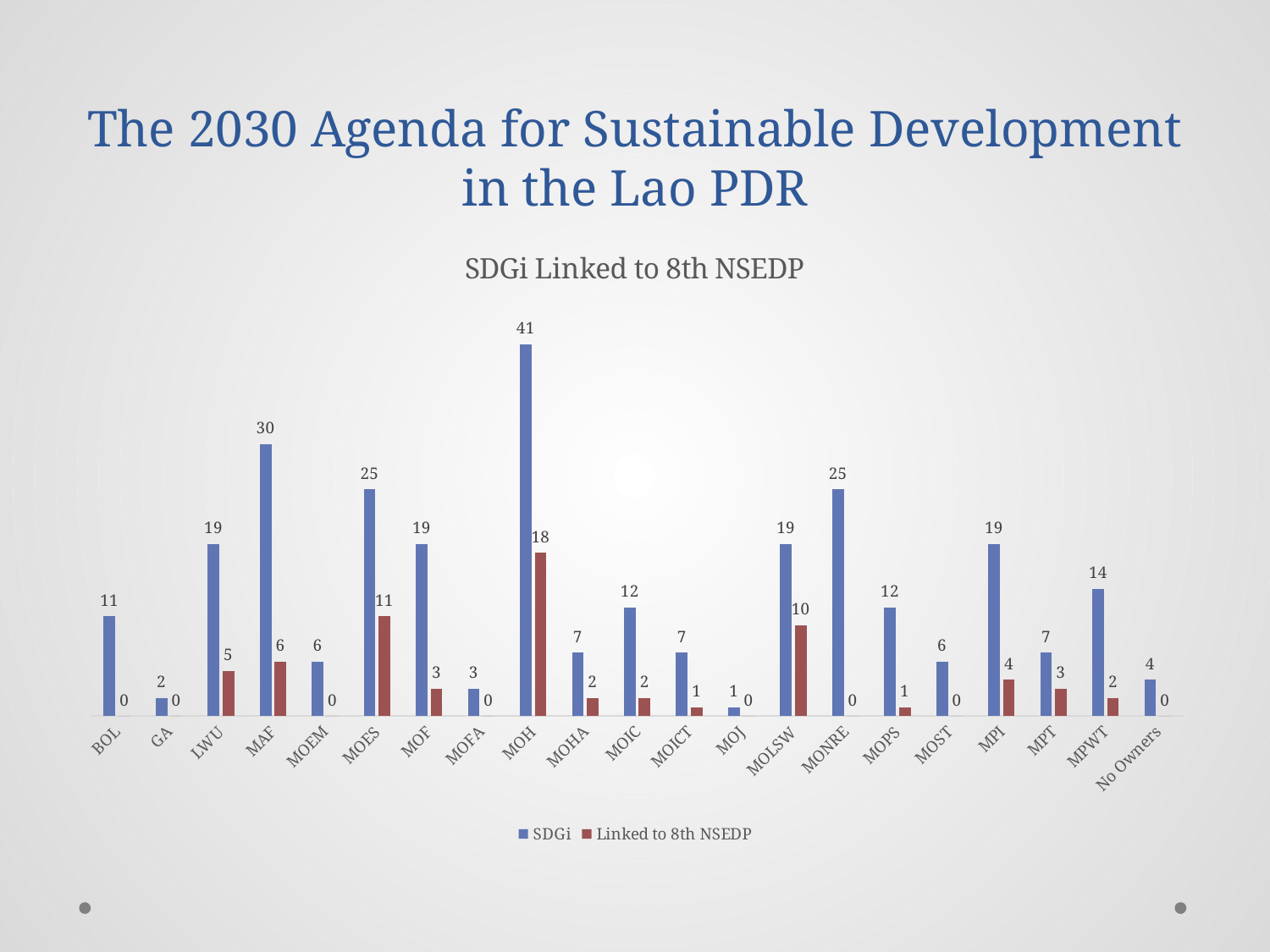
What is the difference between the SDGi value and the Linked to 8th NSEDP value for MOH? 23 Which category has the lowest SDGi value? MOJ What is the SDGi value for MPWT? 14 What kind of chart is shown on the slide? Bar chart Which is larger, the SDGi value for MAF or the SDGi value for MONRE? MAF What is the Linked to 8th NSEDP value for MOES? 11 Which category has the highest SDGi value? MOH How many categories are shown on the x axis? 21 How many series does the legend list? 2 What is the title of the chart? SDGi Linked to 8th NSEDP What is the SDGi value for MOH? 41 Which series is shown in red? Linked to 8th NSEDP